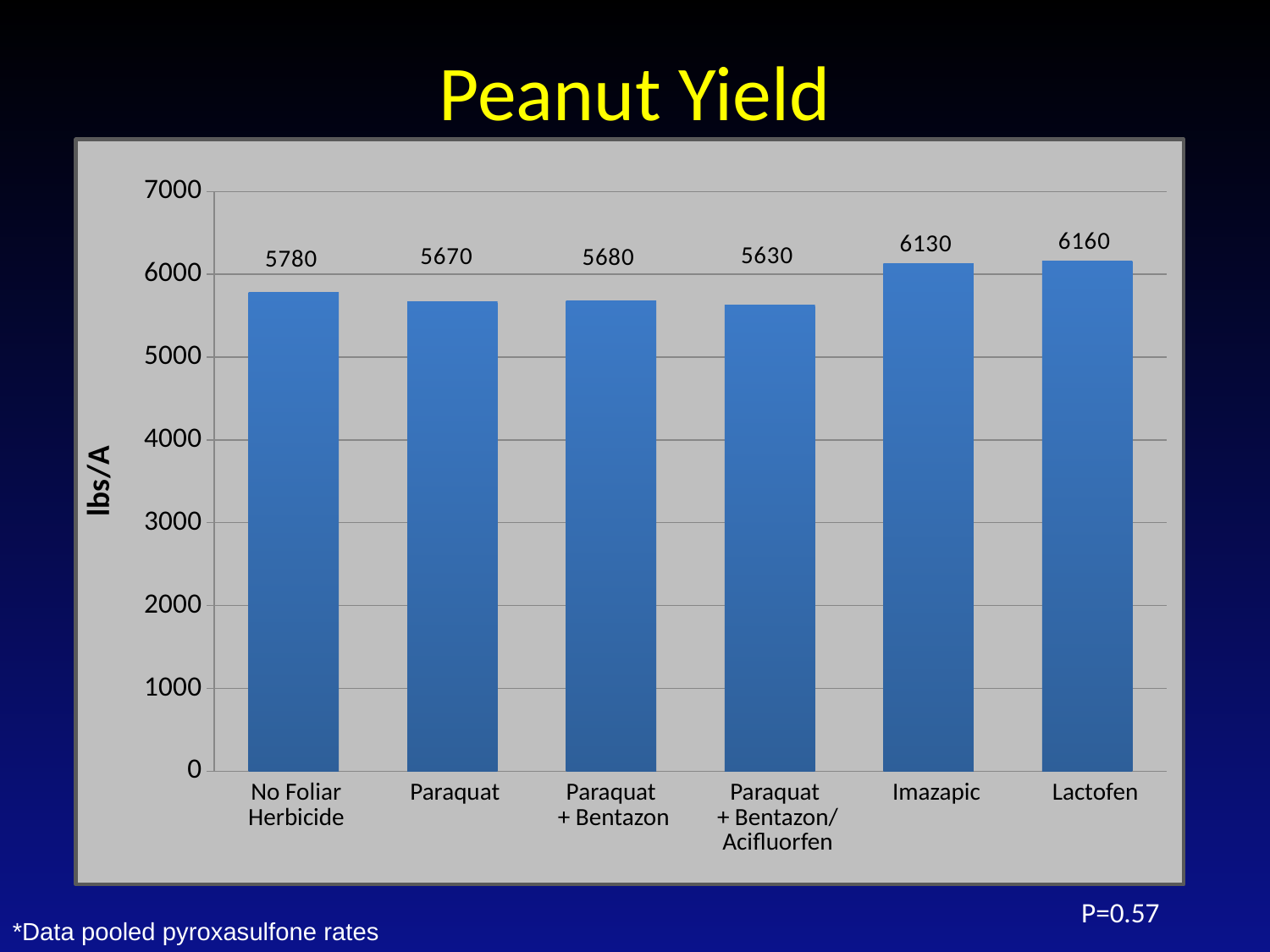
Which treatment has the lowest peanut yield? Paraquat + Bentazon/Acifluorfen What is the label on the vertical axis of the chart? lbs/A What is the difference in peanut yield between Imazapic and No Foliar Herbicide? 350 What is the peanut yield for No Foliar Herbicide? 5780 Which treatment has the highest peanut yield? Lactofen Is the peanut yield for Lactofen greater or less than 6000? greater What is the peanut yield for Paraquat + Bentazon/Acifluorfen? 5630 What kind of chart is shown on the slide? bar chart What is the difference in peanut yield between Lactofen and Paraquat? 490 Which has a higher peanut yield, Imazapic or Paraquat + Bentazon? Imazapic What is the peanut yield for Imazapic? 6130 How many treatments are shown on the chart? 6